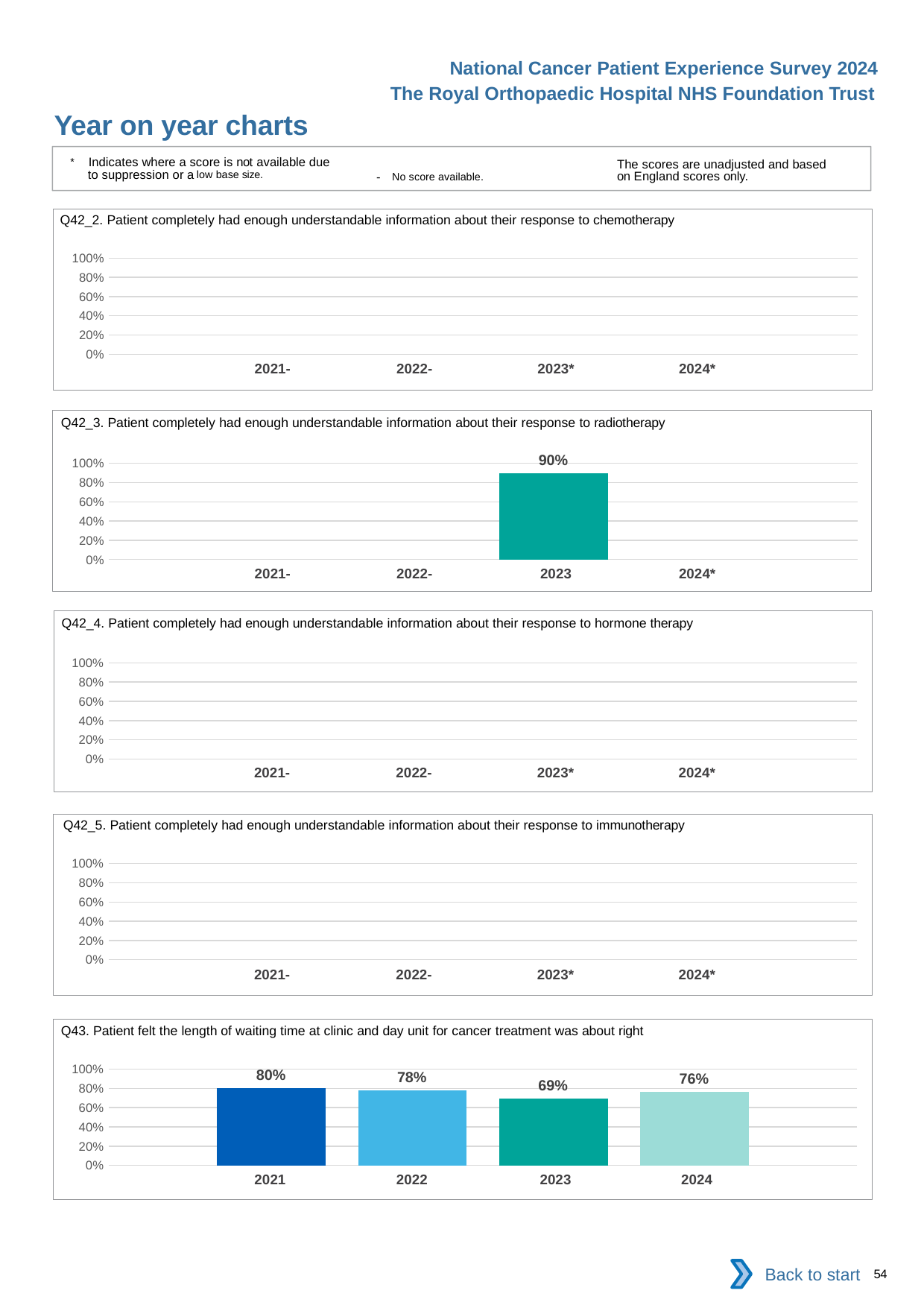
In the Q43 chart, what is the value for 2023? 69% In the Q42_3 chart, is the value for 2023 greater or less than 80%? greater In the Q43 chart, what is the difference between the 2021 and 2023 values? 11% How many charts are shown on the slide? 5 In the Q43 chart, what is the value for 2021? 80% In the Q43 chart, which year has the lowest value? 2023 In the Q43 chart, how many years are shown on the x axis? 4 What kind of chart is the Q43 chart? bar chart In the Q43 chart, which year has the highest value? 2021 In the Q42_3 chart, what is the value for 2023? 90% In the Q43 chart, what is the value for 2024? 76% In the Q43 chart, which is larger, the value for 2022 or the value for 2024? 2022